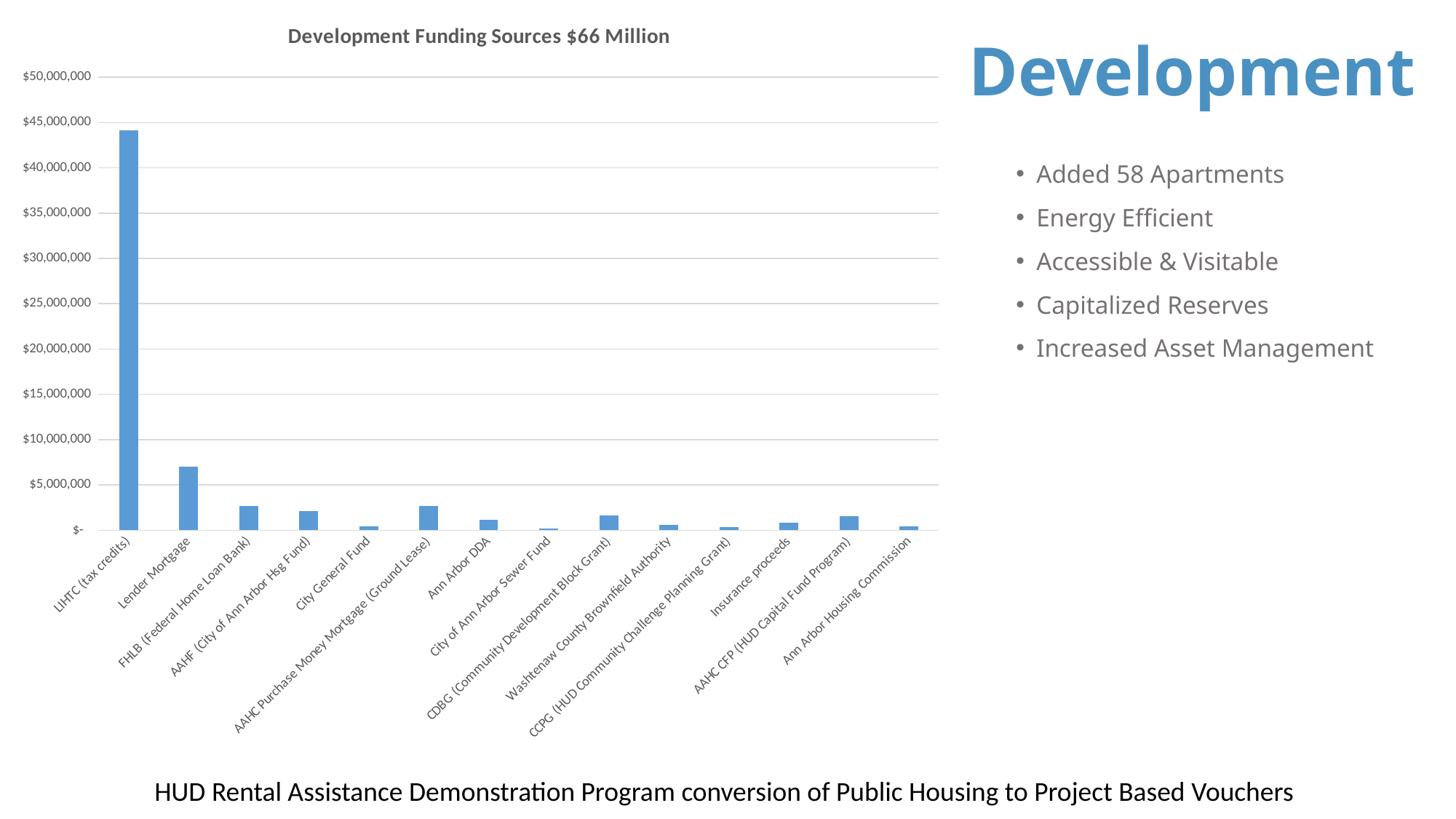
What is the title of the chart? Development Funding Sources $66 Million Which is larger, the value for Lender Mortgage or the value for FHLB (Federal Home Loan Bank)? Lender Mortgage What kind of chart is shown on the slide? Bar chart Is the value for LIHTC (tax credits) greater or less than $40,000,000? greater How many funding source categories are shown on the x axis of the chart? 14 Is the value for Lender Mortgage greater or less than $5,000,000? greater Which funding source has the highest value in the chart? LIHTC (tax credits) What total funding amount is stated in the chart title? $66 Million Which funding source has the lowest value in the chart? City of Ann Arbor Sewer Fund Is the value for Ann Arbor DDA greater or less than $5,000,000? less Which is larger, the value for LIHTC (tax credits) or the value for Lender Mortgage? LIHTC (tax credits)